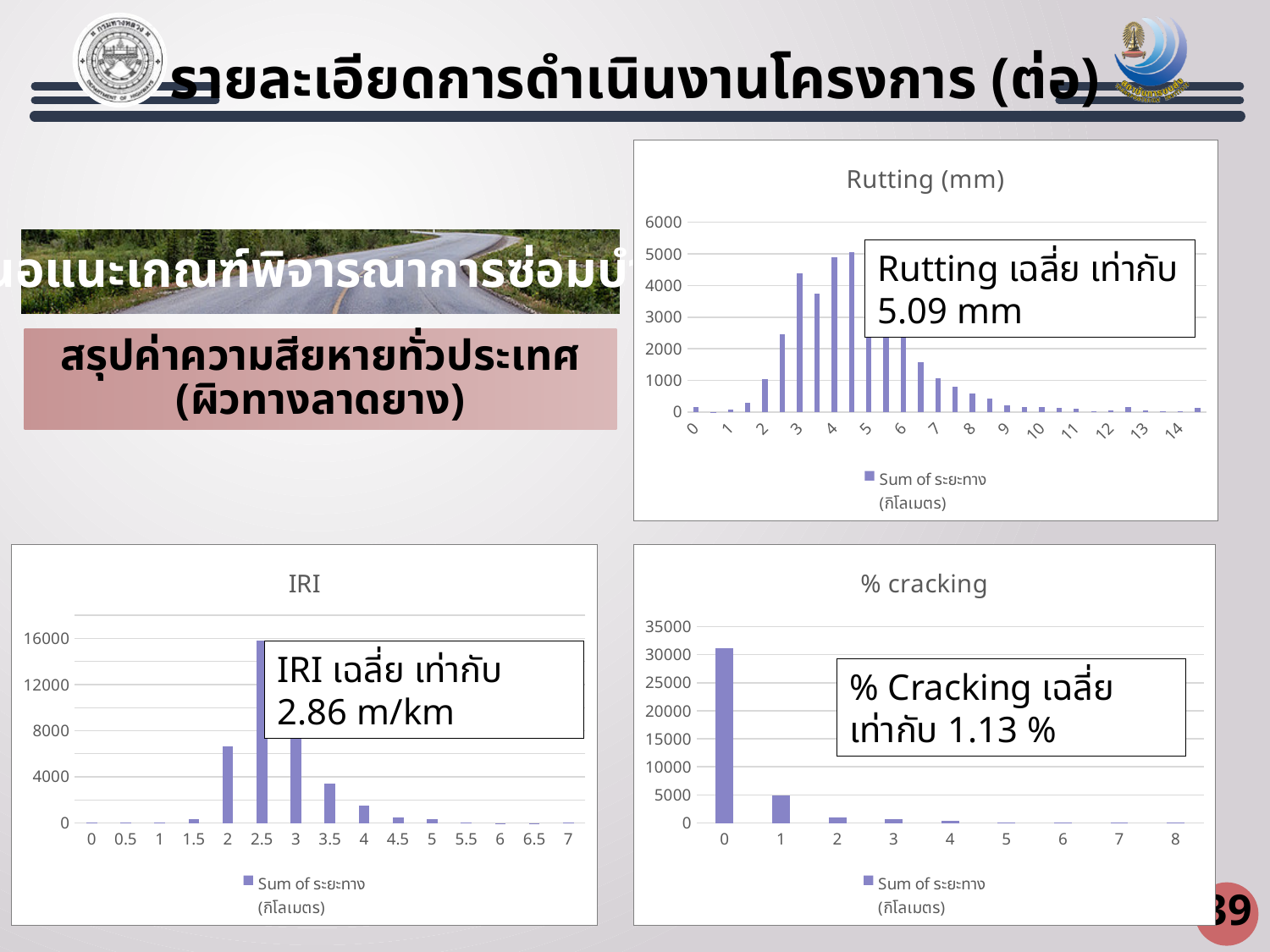
In the "IRI" chart, is the value for 2.5 greater or less than 12000? greater In the "Rutting (mm)" chart, is the value for 3 greater or less than 4000? greater What kind of chart is the "Rutting (mm)" chart? bar chart According to the text box on the "Rutting (mm)" chart, what is the average rutting value? 5.09 mm In the "IRI" chart, which category has the highest value? 2.5 In the "% cracking" chart, which category has the highest value? 0 In the "% cracking" chart, how many categories are shown on the x axis? 9 In the "Rutting (mm)" chart, is the value for 6 greater or less than 2000? greater In the "IRI" chart, which is larger, the value for 2 or the value for 3.5? 2 How many series does the legend of the "IRI" chart list? 1